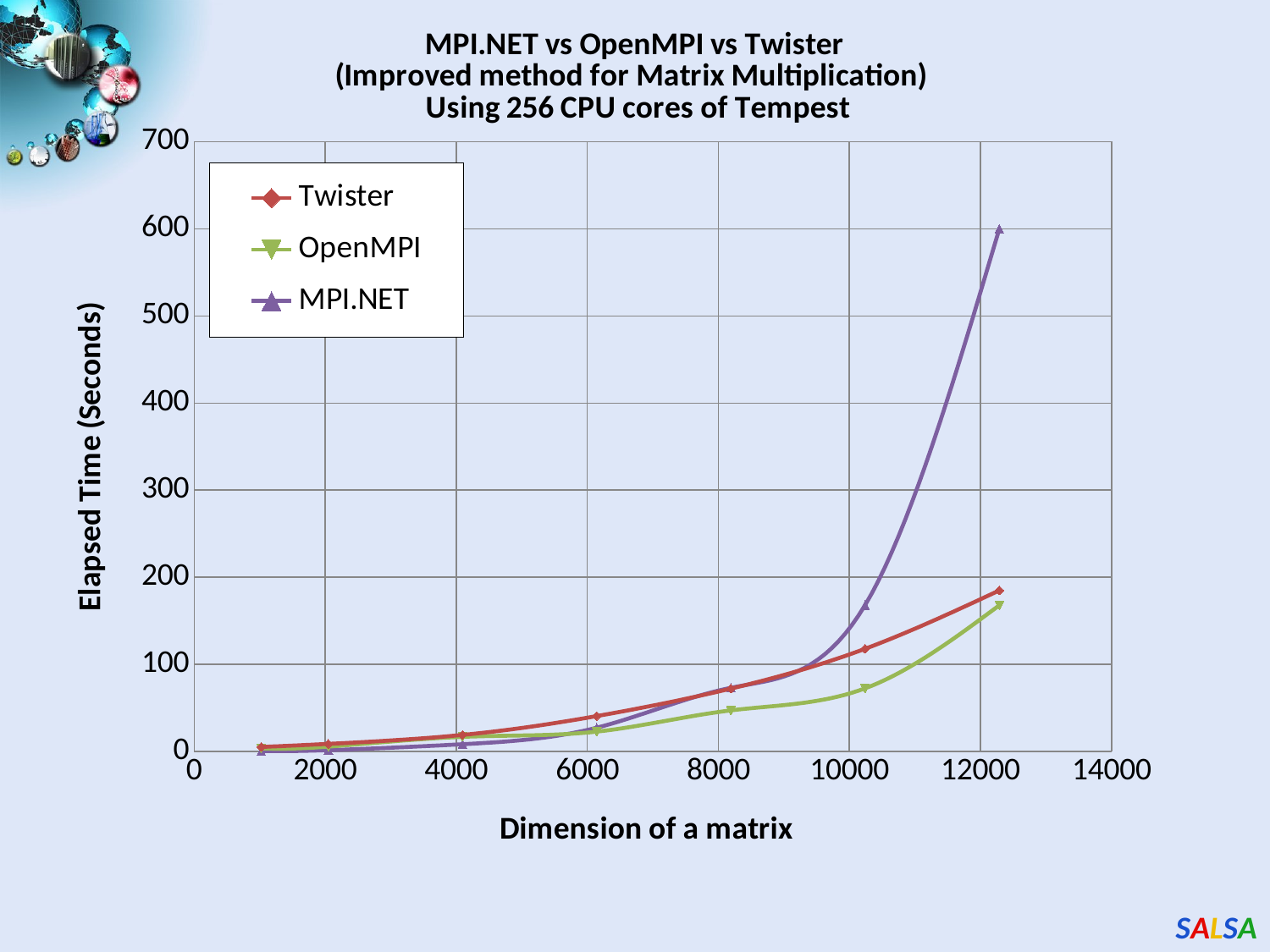
How many series does the legend list? 3 Is the elapsed time for OpenMPI at a matrix dimension of about 10000 greater or less than 100 seconds? less How many data points are plotted for the Twister series? 7 What is the label of the y axis? Elapsed Time (Seconds) At a matrix dimension of about 10000, which has the larger elapsed time, Twister or OpenMPI? Twister Is the elapsed time for MPI.NET at the largest matrix dimension greater or less than 500 seconds? greater Which series are listed in the legend? Twister, OpenMPI, MPI.NET Is the elapsed time for MPI.NET at a matrix dimension of about 10000 greater or less than 100 seconds? greater Which series has the highest elapsed time at the largest matrix dimension plotted? MPI.NET What kind of chart is shown on the slide? line chart Does the elapsed time for MPI.NET rise or fall as the matrix dimension increases? rise